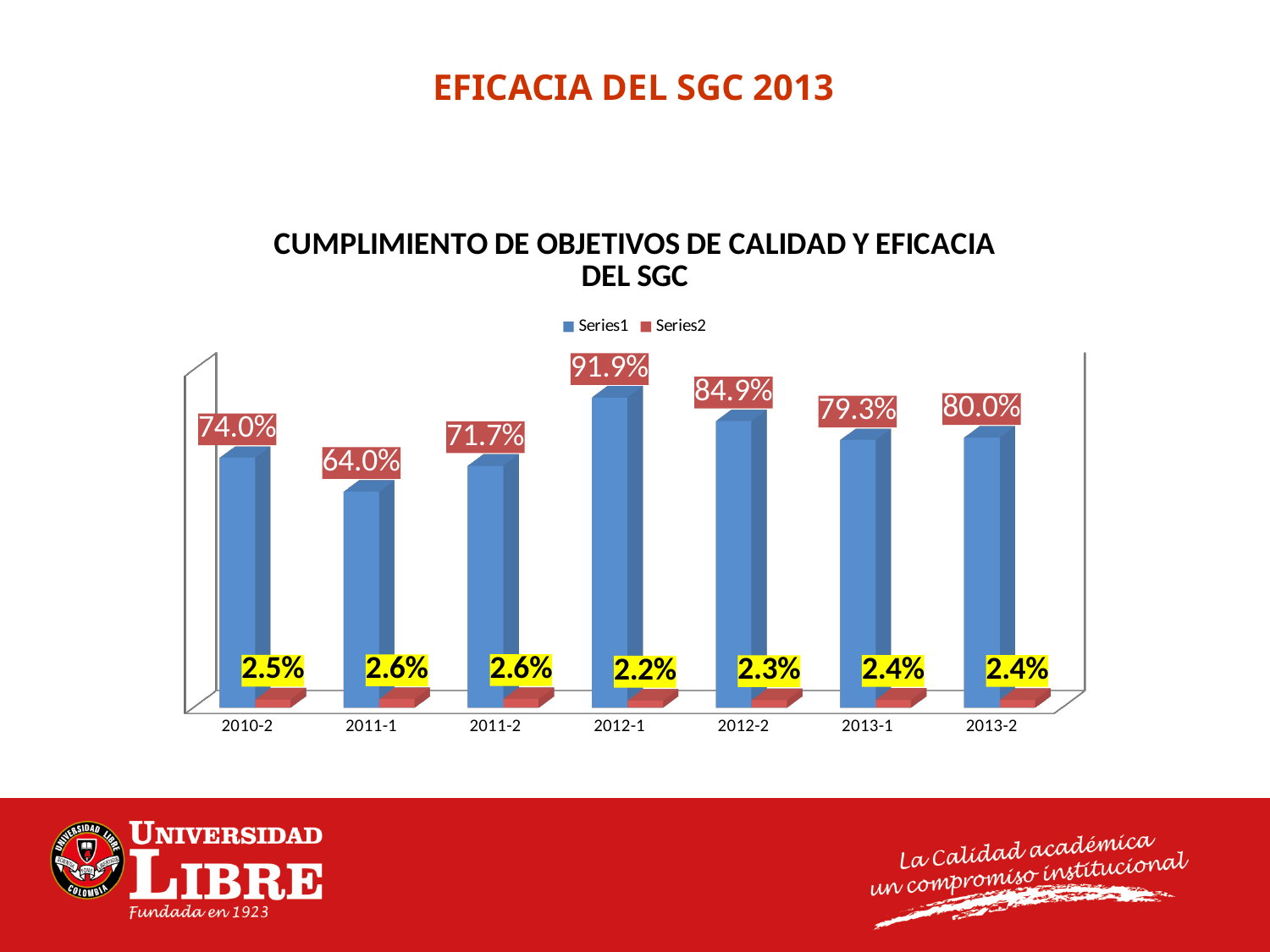
How many series does the legend list? 2 What kind of chart is shown on the slide? Bar chart Which period has the lowest Series1 value? 2011-1 What is the Series2 value for 2011-1? 2.6% What is the Series1 value for 2013-2? 80.0% What is the difference between the Series1 values for 2012-1 and 2012-2? 7.0% Which period has the lowest Series2 value? 2012-1 Which is larger, the Series1 value for 2010-2 or for 2011-2? 2010-2 What is the title of the chart? CUMPLIMIENTO DE OBJETIVOS DE CALIDAD Y EFICACIA DEL SGC What is the Series1 value for 2012-1? 91.9% How many periods are shown on the x axis? 7 Which period has the highest Series1 value? 2012-1